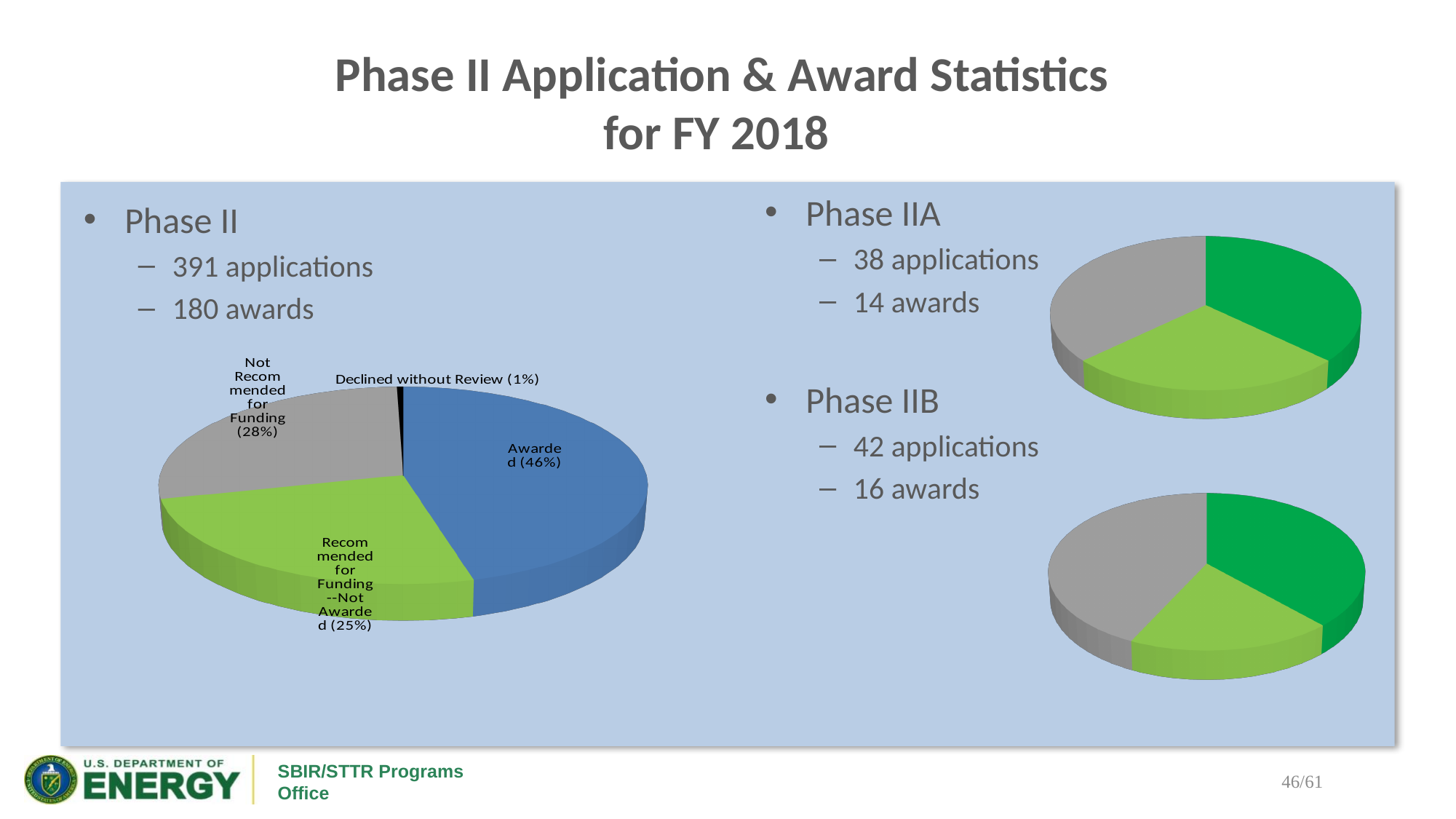
In the Phase II pie chart on the left, which category has the largest slice? Awarded How many pie charts are shown on the slide? 3 In the Phase II pie chart on the left, which slice is larger: Not Recommended for Funding or Recommended for Funding--Not Awarded? Not Recommended for Funding In the Phase II pie chart on the left, what is the difference in percentage points between the Awarded slice and the Not Recommended for Funding slice? 18 In the Phase II pie chart on the left, what share of applications were Recommended for Funding--Not Awarded? 25% In the Phase II pie chart on the left, what share of applications were Not Recommended for Funding? 28% In the Phase II pie chart on the left, which category has the smallest slice? Declined without Review In the Phase II pie chart on the left, what share of applications were Awarded? 46% What kind of chart is the Phase II chart on the left of the slide? pie chart In the Phase II pie chart on the left, what colour is the Awarded slice? blue In the Phase II pie chart on the left, how many slices does the pie have? 4